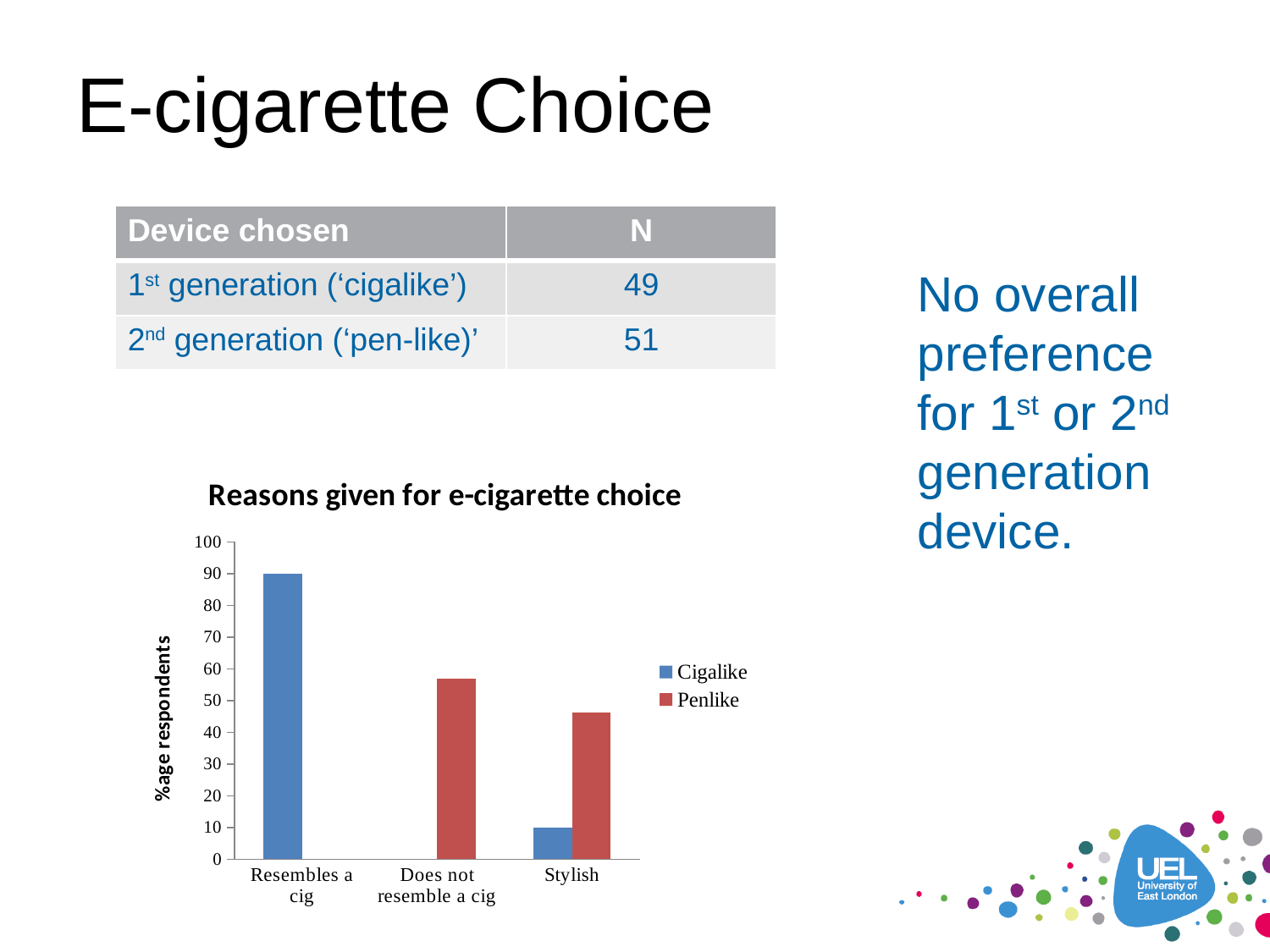
In the 'Stylish' category, which series has the larger value, Cigalike or Penlike? Penlike What is the value for Cigalike in the 'Stylish' category? 10 For the Penlike series, which is larger: 'Does not resemble a cig' or 'Stylish'? Does not resemble a cig How many series does the legend of the 'Reasons given for e-cigarette choice' chart list? 2 Is the value for Penlike in the 'Does not resemble a cig' category greater or less than 50? greater Is the value for Penlike in the 'Stylish' category greater or less than 50? less How many reason categories are shown on the x axis of the chart? 3 What is the label on the y axis of the chart? %age respondents What is the value for Cigalike in the 'Resembles a cig' category? 90 What kind of chart is shown under the title 'Reasons given for e-cigarette choice'? bar chart Which series has the lowest bar in the chart, and in which category? Cigalike, Stylish Which category has the highest bar in the chart? Resembles a cig